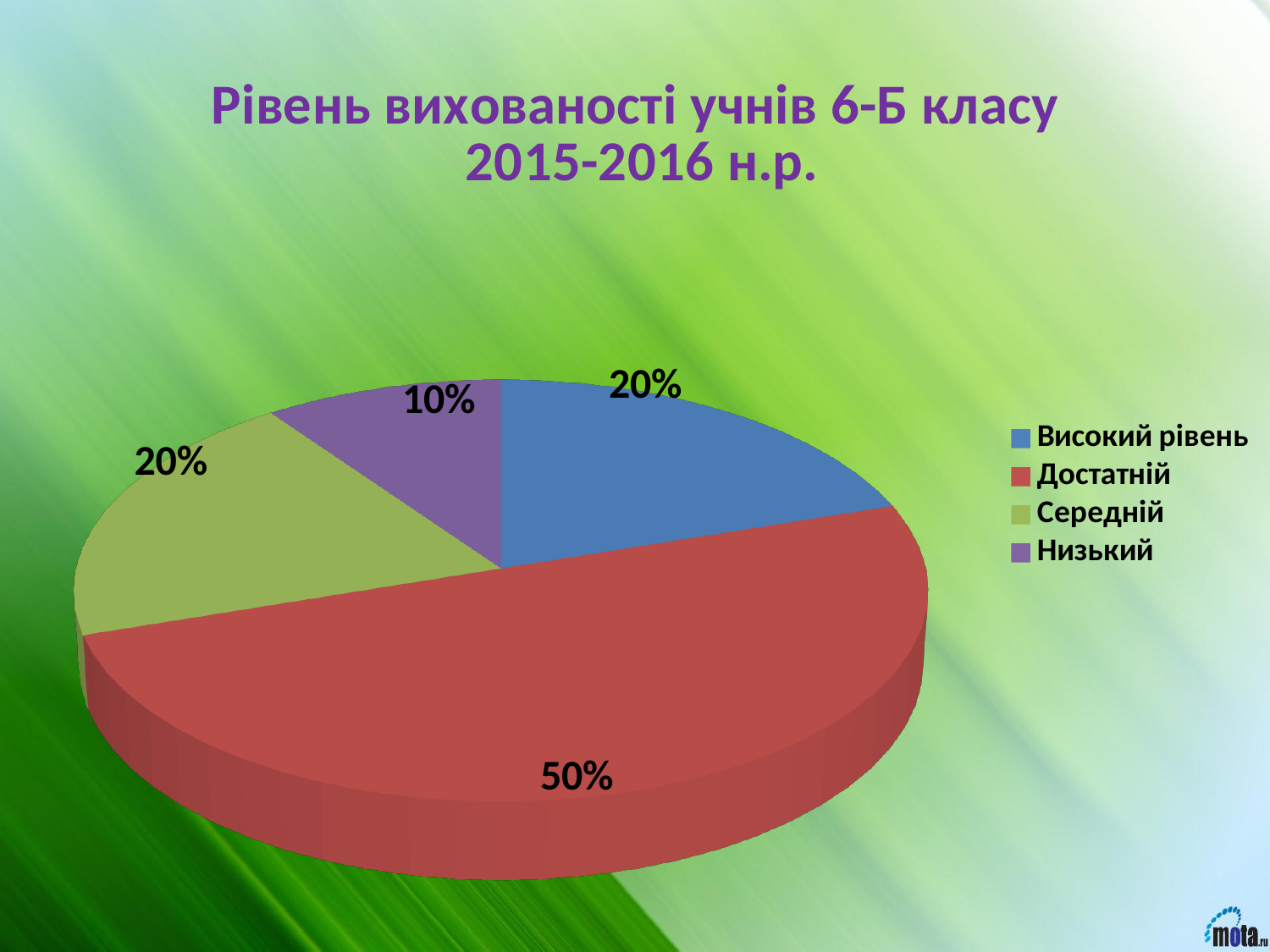
How many entries does the legend list? 4 What is the value shown for Високий рівень? 20% What kind of chart is shown on the slide? pie chart What is the value shown for Низький? 10% Which category has the smallest slice of the pie? Низький Which is larger, the value for Достатній or the value for Високий рівень? Достатній What is the difference between the Достатній and Низький values? 40% What is the value shown for Середній? 20% What share of the pie does the Достатній slice take? 50% What colour is the Достатній slice in the pie chart? red Which category has the largest slice of the pie? Достатній How many slices does the pie chart have? 4